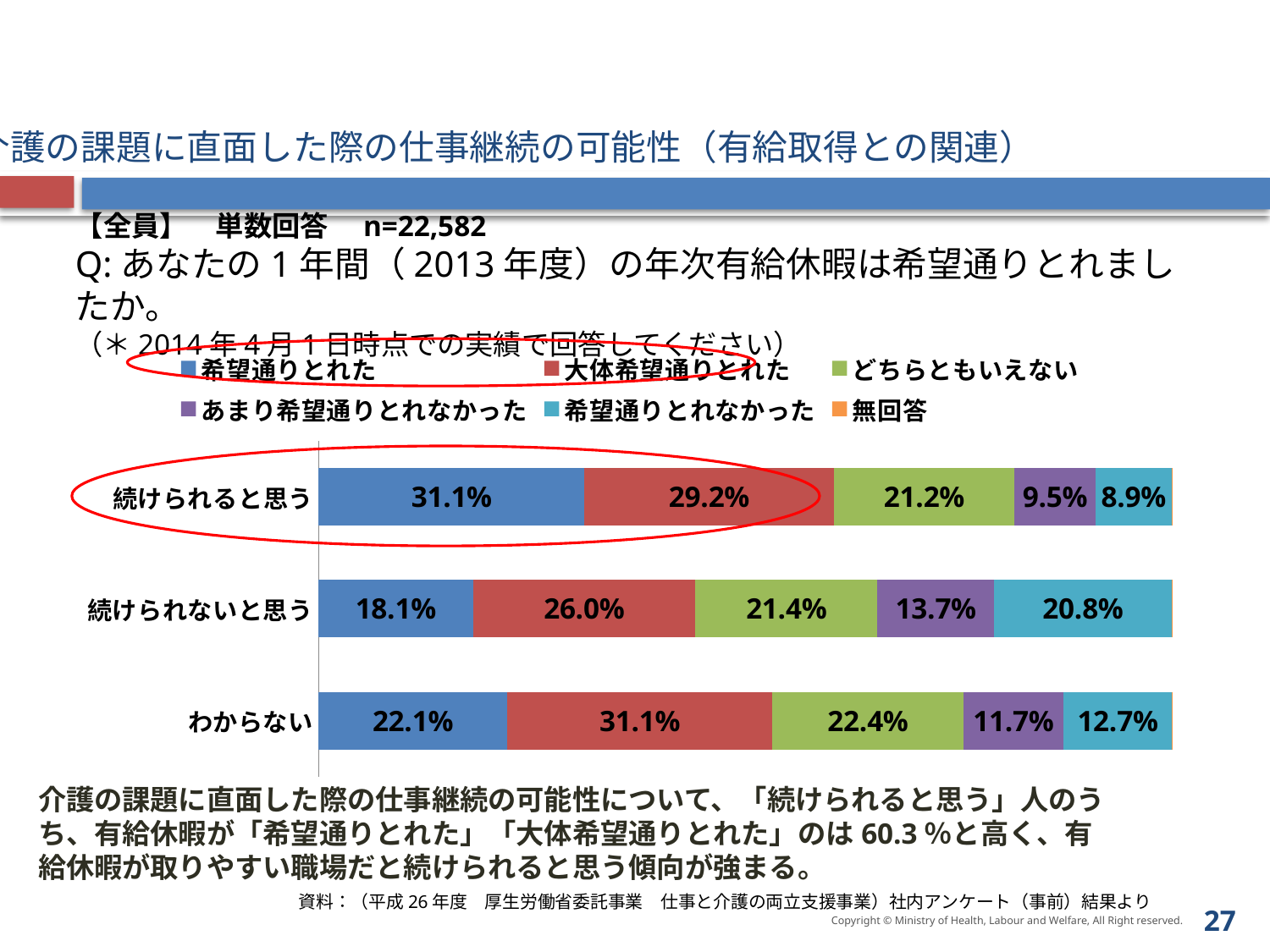
Which is larger: the 希望通りとれなかった value for 続けられないと思う or for わからない? 続けられないと思う What is the value of 希望通りとれなかった for わからない? 12.7% How many categories are plotted on the vertical axis of the chart? 3 Which category has the lowest value for 希望通りとれなかった? 続けられると思う What is the value of 希望通りとれた for 続けられると思う? 31.1% What is the value of 大体希望通りとれた for 続けられないと思う? 26.0% Which category has the highest value for 希望通りとれた? 続けられると思う What is the value of あまり希望通りとれなかった for 続けられると思う? 9.5% What kind of chart is shown on the slide? stacked bar chart Which legend entry is shown in green? どちらともいえない What is the difference between the 希望通りとれた values for 続けられると思う and 続けられないと思う? 13.0% How many series does the chart's legend list? 6